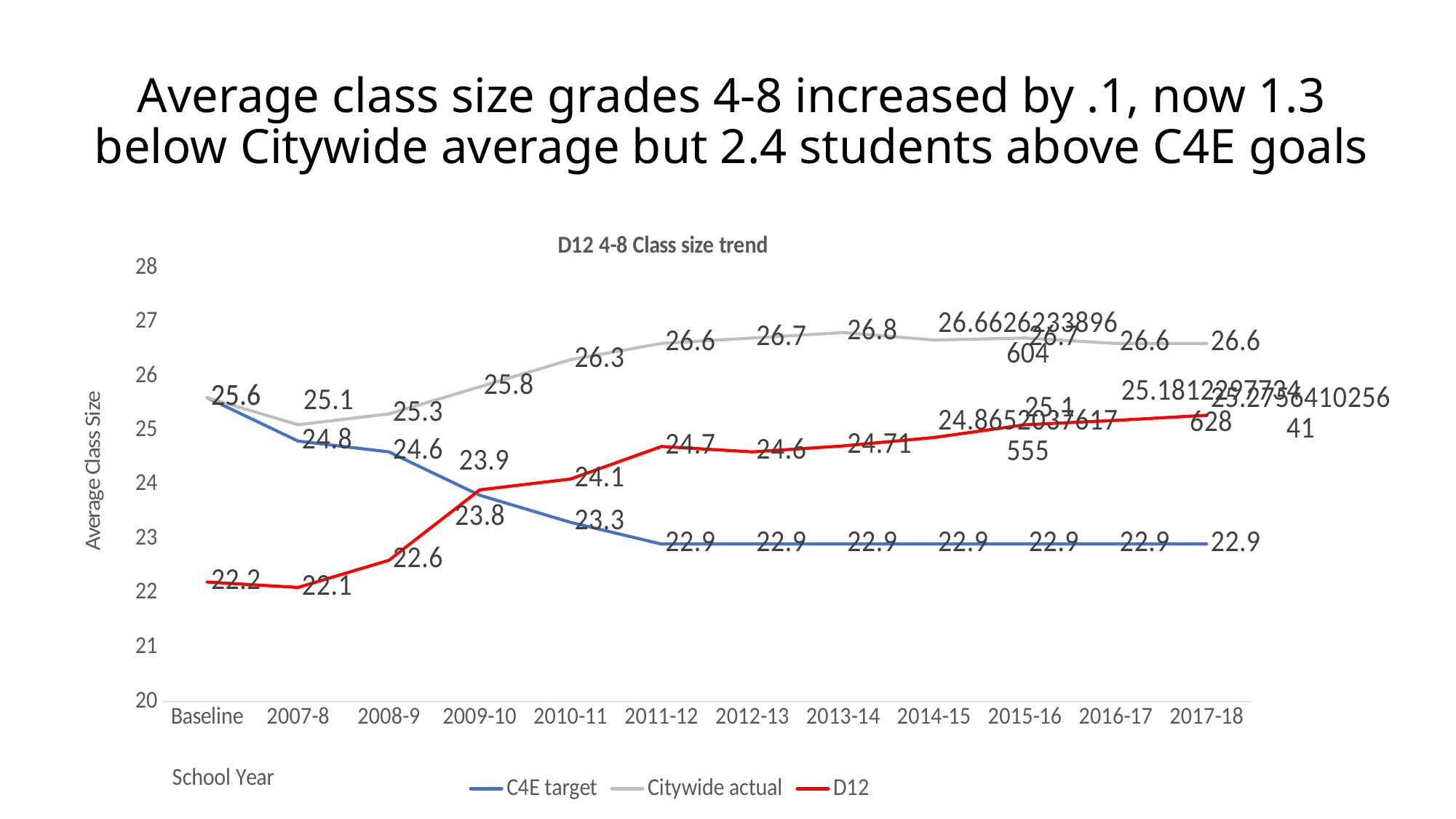
Is the D12 value for 2017-18 greater or less than 25? greater How many school years are plotted along the x axis? 12 In 2011-12, which is larger: the Citywide actual or the D12 value? Citywide actual What is the D12 value for 2009-10? 23.9 How many series does the legend list? 3 What is the Citywide actual value for 2012-13? 26.7 At which school year is the C4E target highest? Baseline What is the D12 value for 2013-14? 24.71 What type of chart is shown on the slide? Line chart What is the C4E target value for 2007-8? 24.8 Does the D12 line generally rise or fall from Baseline to 2017-18? Rise What is the difference between the Citywide actual and the C4E target in 2011-12? 3.7